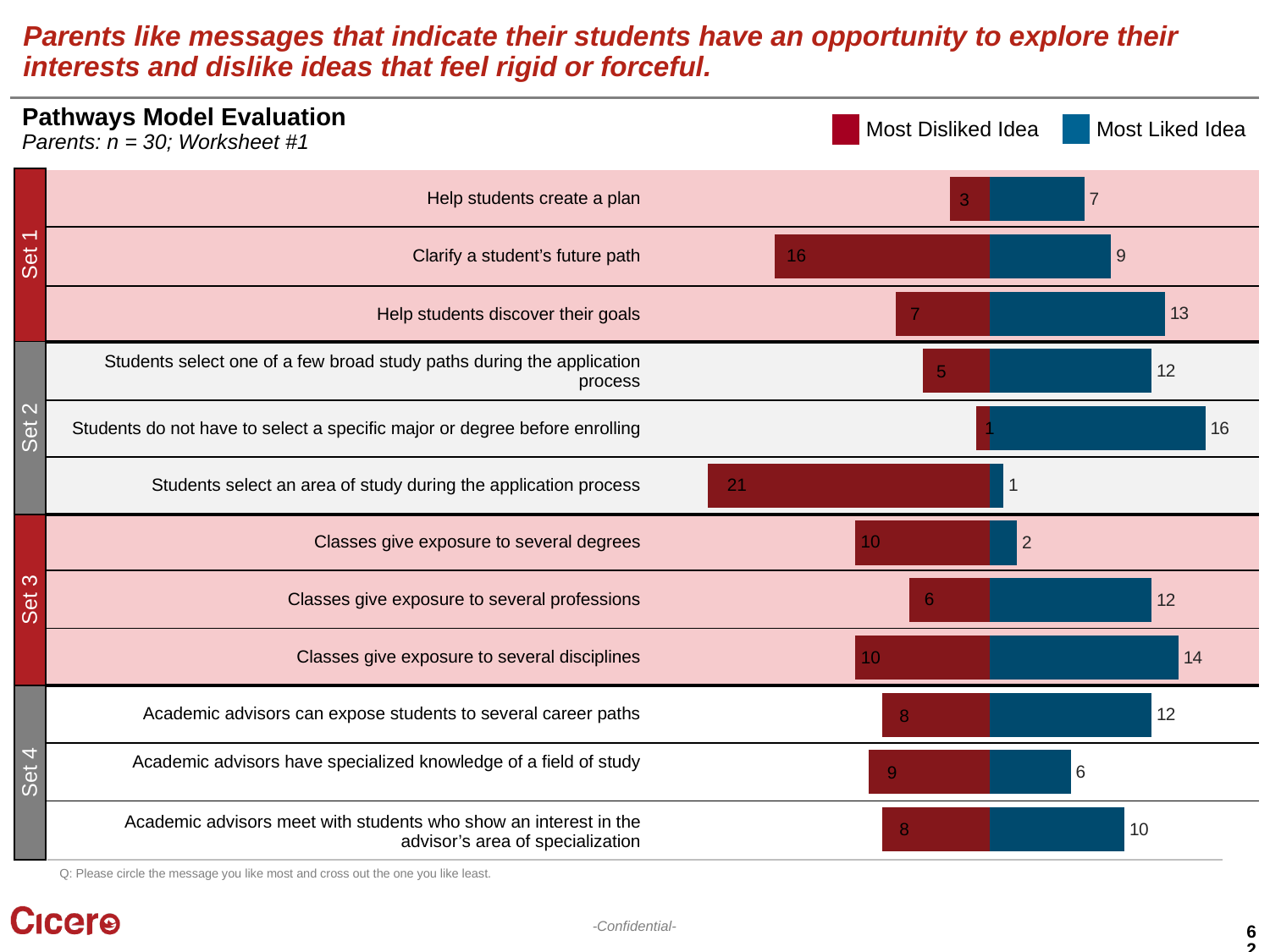
What kind of chart is shown on the slide? Bar chart How many series does the legend list? 2 For "Classes give exposure to several degrees", which is larger: the Most Disliked Idea value or the Most Liked Idea value? Most Disliked Idea What is the difference between the Most Liked Idea and Most Disliked Idea values for "Clarify a student's future path"? 7 What is the Most Liked Idea value for "Help students discover their goals"? 13 Which message has the lowest Most Liked Idea value? Students select an area of study during the application process How many messages are shown in the chart? 12 Which message has the highest Most Disliked Idea value? Students select an area of study during the application process What is the Most Disliked Idea value for "Students select an area of study during the application process"? 21 What is the Most Liked Idea value for "Students do not have to select a specific major or degree before enrolling"? 16 What colour represents the Most Liked Idea series? Blue What is the Most Disliked Idea value for "Academic advisors have specialized knowledge of a field of study"? 9